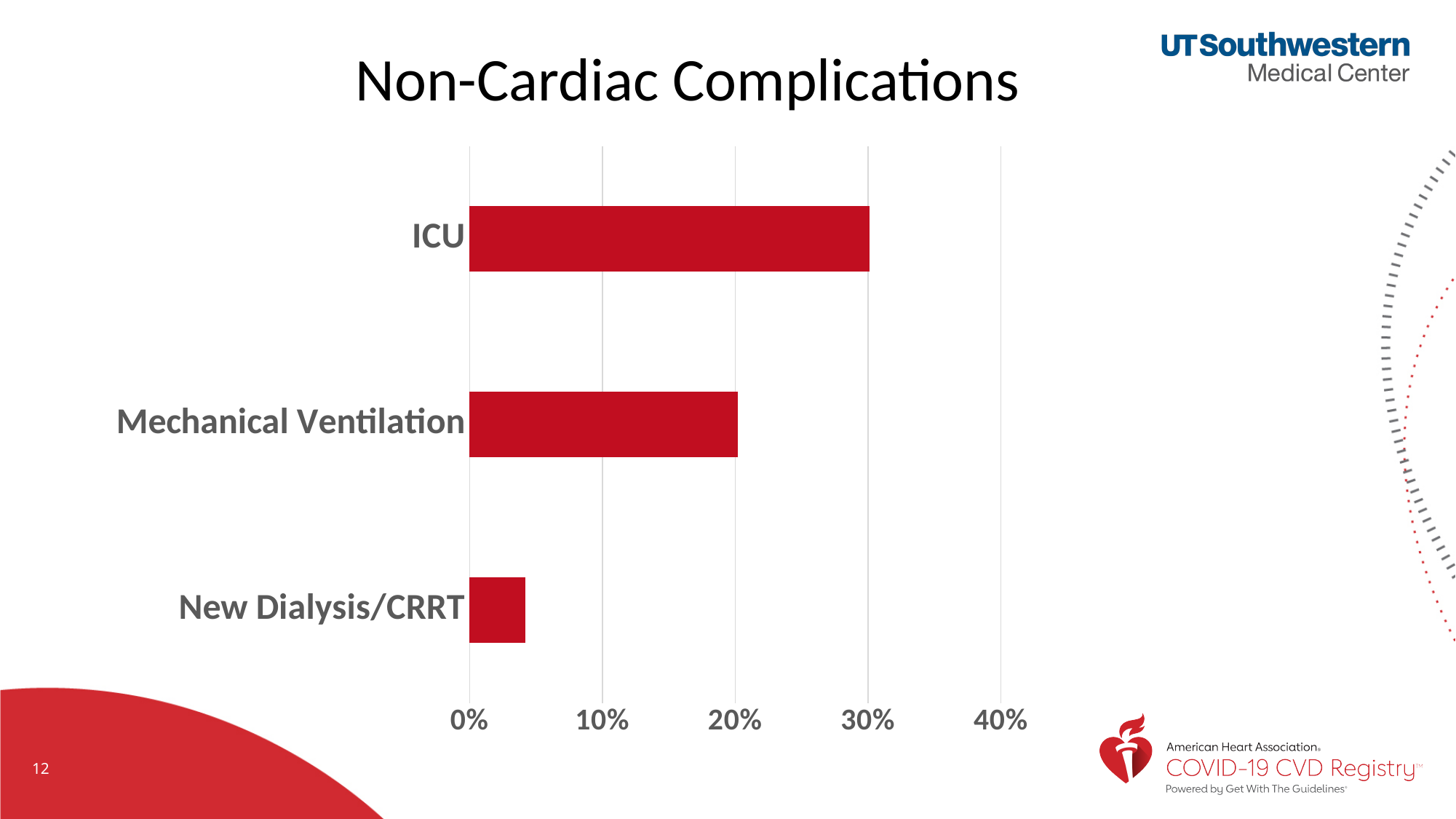
Is the value for New Dialysis/CRRT greater or less than 10%? less Is the value for Mechanical Ventilation greater or less than 10%? greater What is the title of the chart on the slide? Non-Cardiac Complications What is the highest value shown on the x axis of the chart? 40% Is the value for ICU greater or less than 40%? less Which category has the highest value in the chart? ICU How many categories are plotted in the chart? 3 What kind of chart is shown on the slide? bar chart Which category has the lowest value in the chart? New Dialysis/CRRT Which is larger, the value for ICU or the value for Mechanical Ventilation? ICU Which is larger, the value for Mechanical Ventilation or the value for New Dialysis/CRRT? Mechanical Ventilation